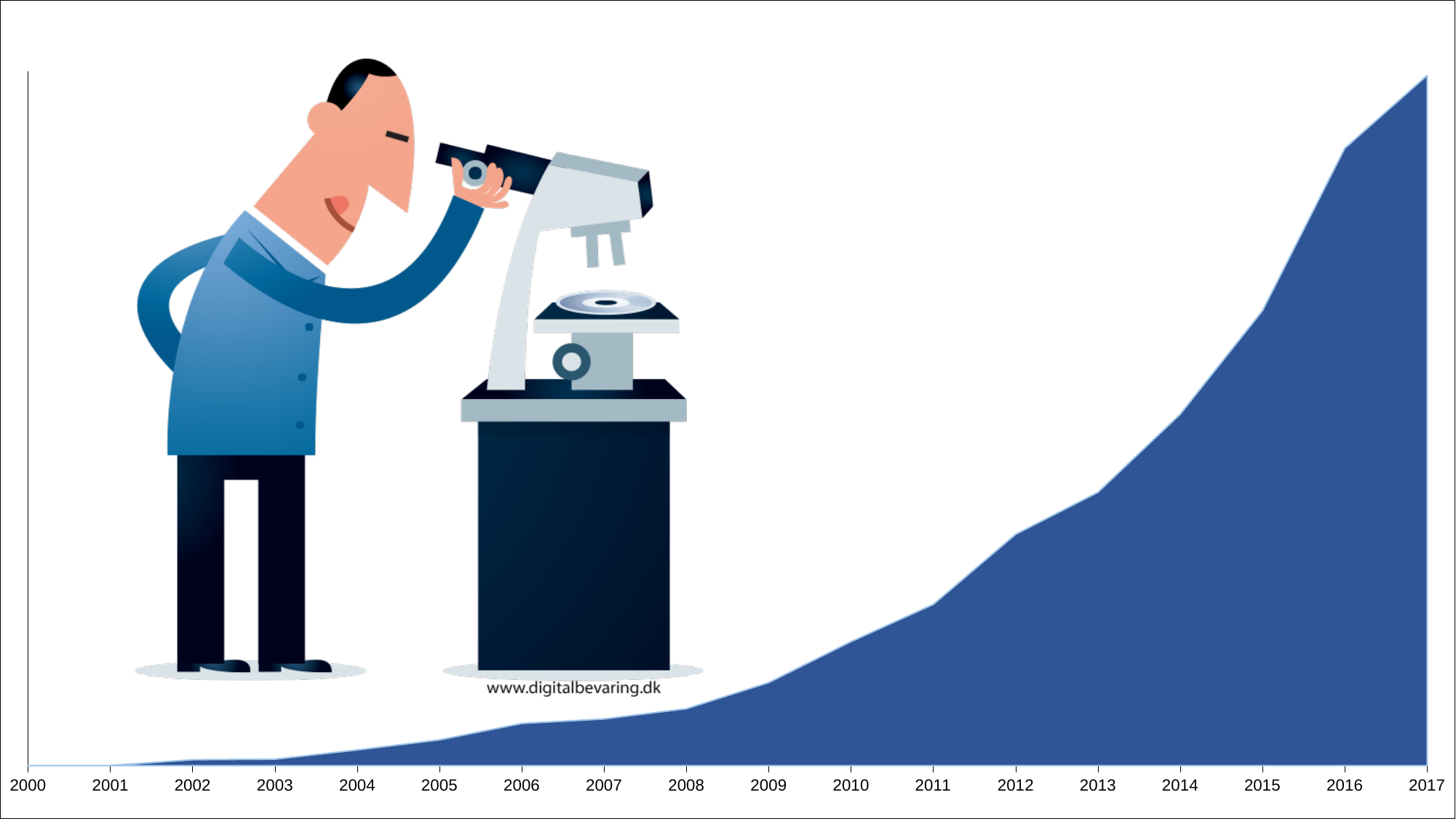
Which year has the larger value, 2015 or 2008? 2015 What is the last year shown on the x axis of the chart? 2017 How many years are labelled along the x axis of the chart? 18 Do the values in the chart rise or fall from 2000 to 2017? Rise Which year has the highest value in the chart? 2017 Which year has the larger value, 2010 or 2016? 2016 How many data series are plotted in the chart? 1 Which year has the larger value, 2005 or 2013? 2013 What kind of chart is shown on the slide? Area chart What is the first year shown on the x axis of the chart? 2000 Which year has the lowest value in the chart? 2000 and 2001 (tied)